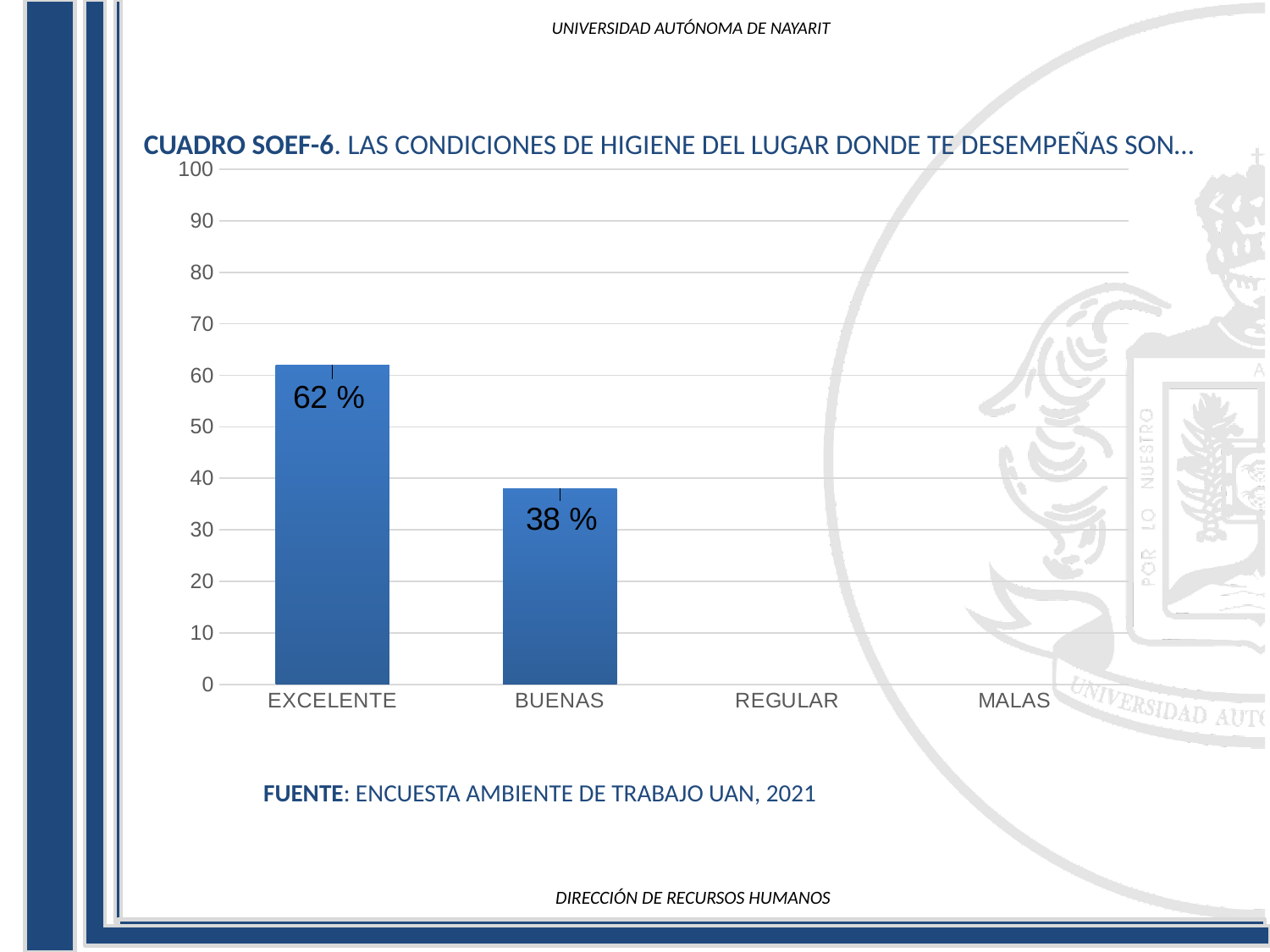
What kind of chart is shown on the slide? bar chart What is the value for BUENAS? 38 % Is the value for EXCELENTE greater or less than 50? greater What is the difference between the values for EXCELENTE and BUENAS? 24 % Which is larger, the value for EXCELENTE or the value for BUENAS? EXCELENTE What is the highest value shown on the y axis? 100 Do the bar values rise or fall from EXCELENTE to BUENAS? fall What is the value for EXCELENTE? 62 % Is the value for BUENAS greater or less than 40? less How many categories are shown on the x axis? 4 Which category has the highest value? EXCELENTE What is the source cited below the chart? ENCUESTA AMBIENTE DE TRABAJO UAN, 2021